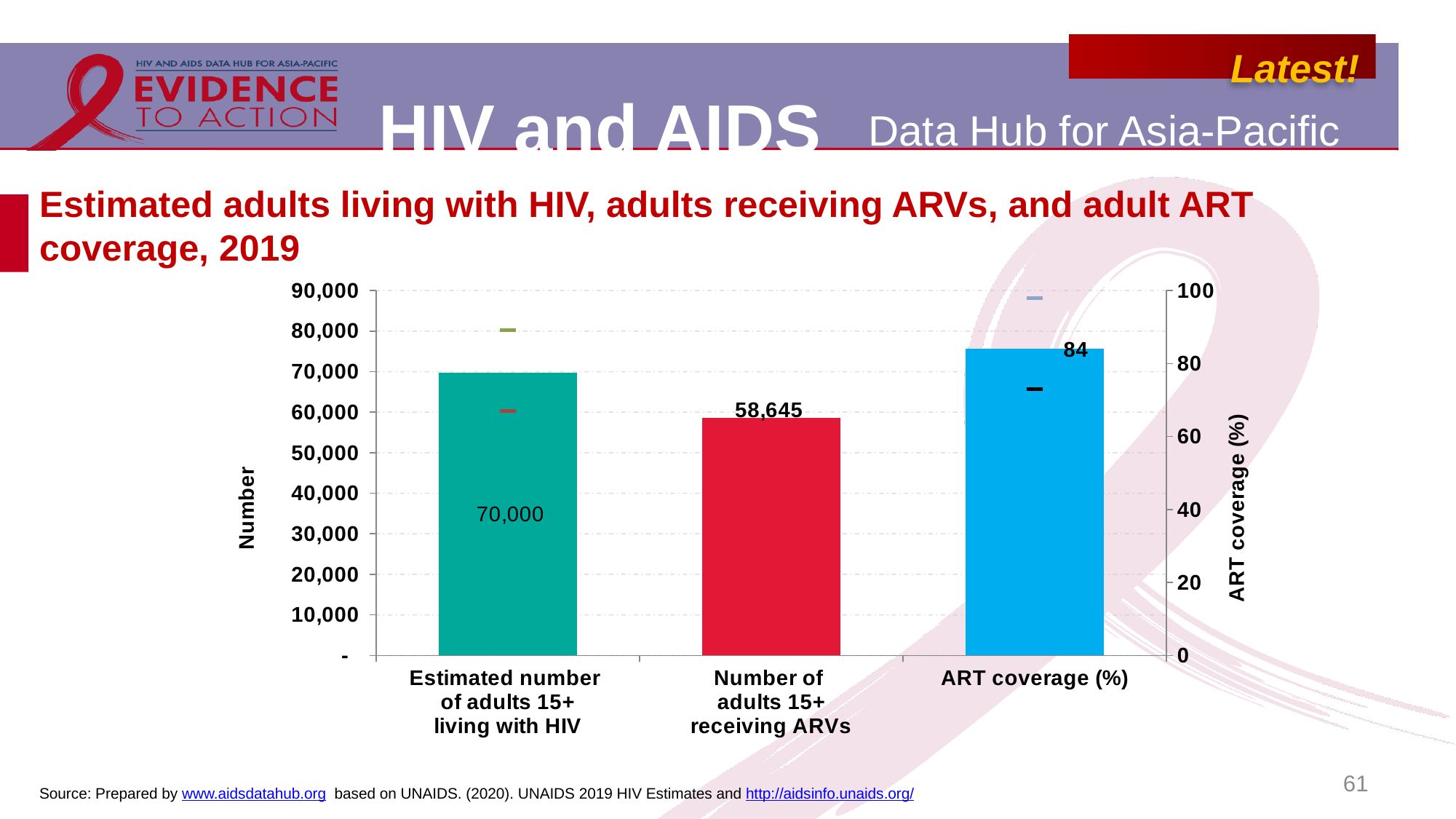
What kind of chart is shown on the slide? Bar chart What is the number of adults 15+ receiving ARVs shown on the chart? 58,645 What is the estimated number of adults 15+ living with HIV shown on the chart? 70,000 What is the ART coverage (%) value shown on the chart? 84 Is the number of adults 15+ receiving ARVs greater or less than 60,000? less How many bars are plotted on the chart? 3 What is the label of the right-hand vertical axis? ART coverage (%) Is the ART coverage (%) value greater or less than 80 on the right-hand axis? greater What is the difference between the estimated number of adults 15+ living with HIV and the number of adults 15+ receiving ARVs? 11,355 Which is larger: the estimated number of adults 15+ living with HIV or the number of adults 15+ receiving ARVs? Estimated number of adults 15+ living with HIV What is the title of the chart on the slide? Estimated adults living with HIV, adults receiving ARVs, and adult ART coverage, 2019